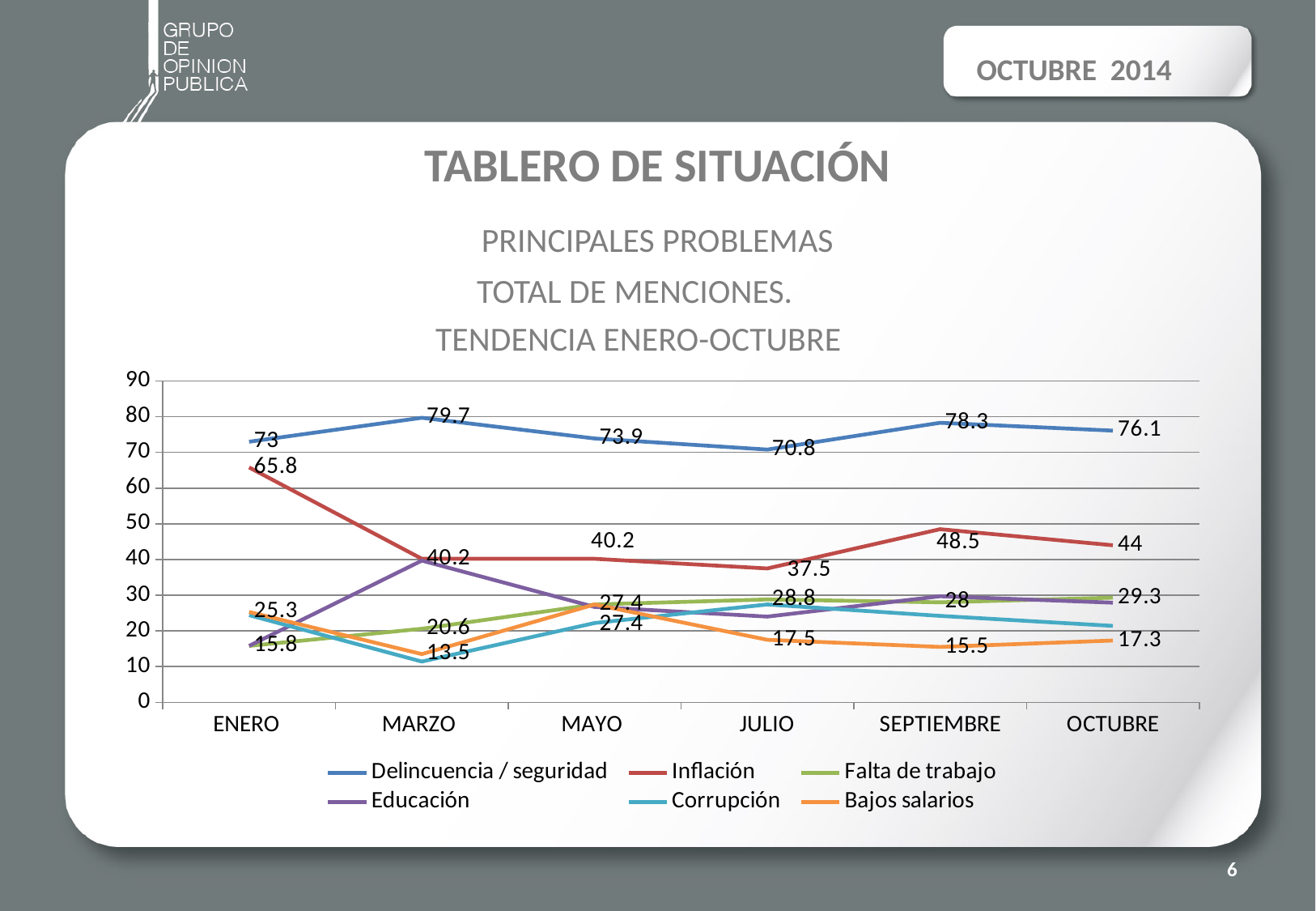
In which month is Delincuencia / seguridad at its highest? MARZO How many months are shown on the x axis? 6 Does Inflación rise or fall from ENERO to MARZO? fall What is the value for Bajos salarios in OCTUBRE? 17.3 What is the difference between Delincuencia / seguridad and Inflación in SEPTIEMBRE? 29.8 What is the value for Inflación in OCTUBRE? 44 What type of chart is shown on the slide? line chart In which month is Delincuencia / seguridad at its lowest? JULIO How many series does the legend list? 6 Which series has the higher value in JULIO, Delincuencia / seguridad or Inflación? Delincuencia / seguridad What is the value for Delincuencia / seguridad in MARZO? 79.7 What is the value for Inflación in ENERO? 65.8